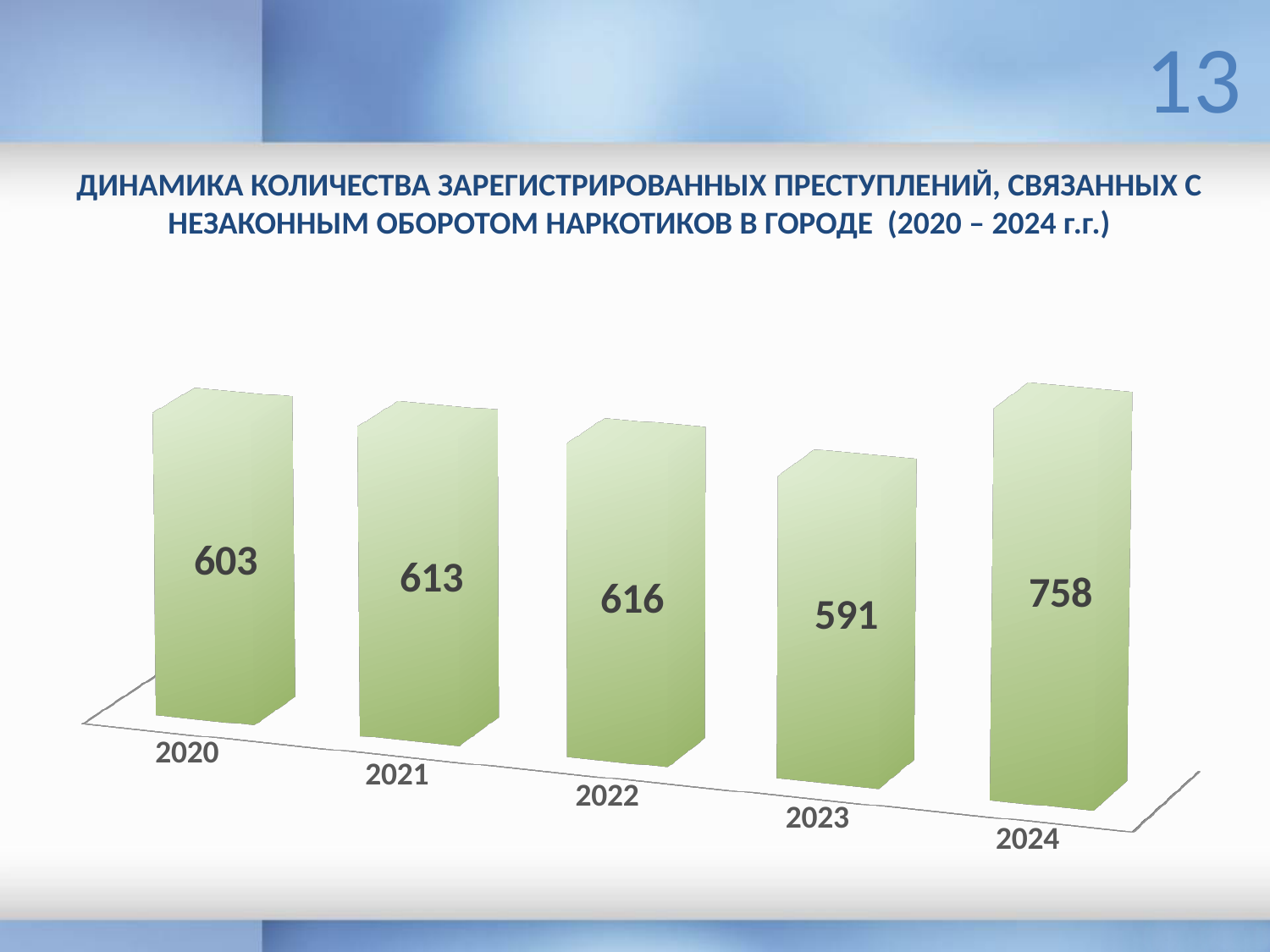
How many years are shown on the chart? 5 Which is larger, the value for 2022 or the value for 2023? 2022 What is the value for 2024? 758 Does the value rise or fall from 2023 to 2024? rise Which year has the highest value? 2024 What kind of chart is shown on the slide? bar chart What is the difference between the values for 2024 and 2023? 167 Which year has the lowest value? 2023 What period does the chart title say the data covers? 2020 – 2024 г.г. What is the value for 2023? 591 What is the difference between the values for 2021 and 2020? 10 What is the value for 2020? 603